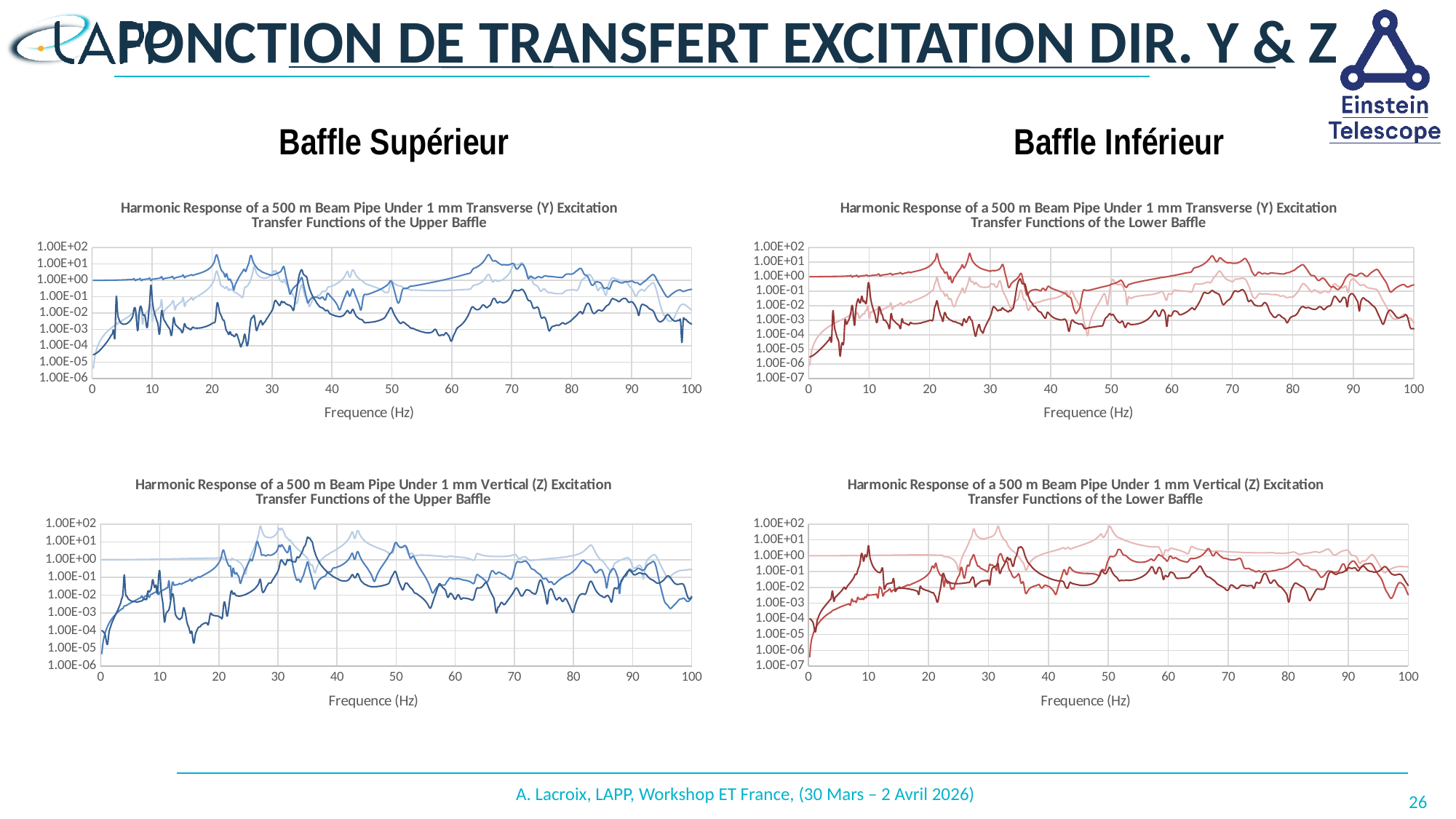
What is the x-axis label of the bottom-left chart (Vertical (Z) Excitation, Upper Baffle)? Frequence (Hz) What kind of chart is the top-left chart titled "Transfer Functions of the Upper Baffle" (Transverse (Y) Excitation)? line chart What is the lowest y-axis tick value on the bottom-right chart (Vertical (Z) Excitation, Lower Baffle)? 1.00E-07 Which colour family is used for the lines in the two charts under the heading "Baffle Inférieur"? red How many charts are shown on the slide? 4 How many lines are plotted in the top-right chart (Transverse (Y) Excitation, Lower Baffle)? 3 What is the highest y-axis tick value on the bottom-left chart (Vertical (Z) Excitation, Upper Baffle)? 1.00E+02 In the top-left chart (Transverse (Y) Excitation, Upper Baffle), is the value of the darkest blue line at 0 Hz greater or less than 1.00E-03? less What is the lowest y-axis tick value on the top-left chart (Transverse (Y) Excitation, Upper Baffle)? 1.00E-06 In the bottom-right chart (Vertical (Z) Excitation, Lower Baffle), is the peak value of the lightest line near 50 Hz greater or less than 1.00E+01? greater What is the highest x-axis tick value on the top-right chart (Transverse (Y) Excitation, Lower Baffle)? 100 In the bottom-left chart (Vertical (Z) Excitation, Upper Baffle), is the value of the lightest blue line at 0 Hz greater or less than 1.00E-01? greater